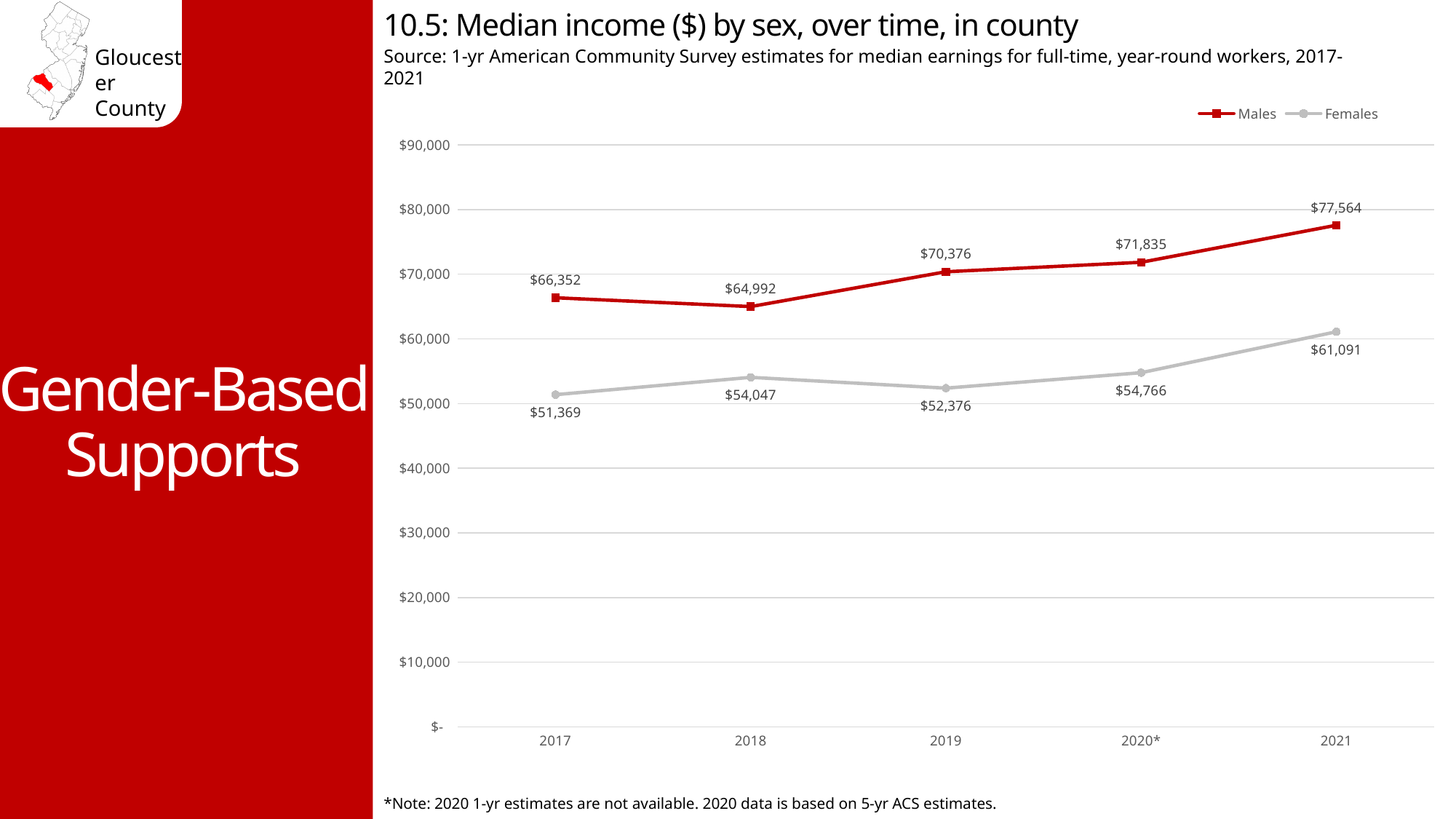
What kind of chart is shown on the slide? line chart In which year is the Females median income lowest? 2017 How many years are shown on the x axis? 5 In which year is the Males median income highest? 2021 What is the median income for Females in 2017? $51,369 How many series does the legend list? 2 What is the median income for Females in 2020*? $54,766 What is the median income for Males in 2021? $77,564 What is the median income for Males in 2019? $70,376 What is the difference between the Males and Females median income in 2021? $16,473 Is the Males median income in 2018 greater or less than $60,000? greater Which is larger, the Females median income in 2018 or in 2019? 2018